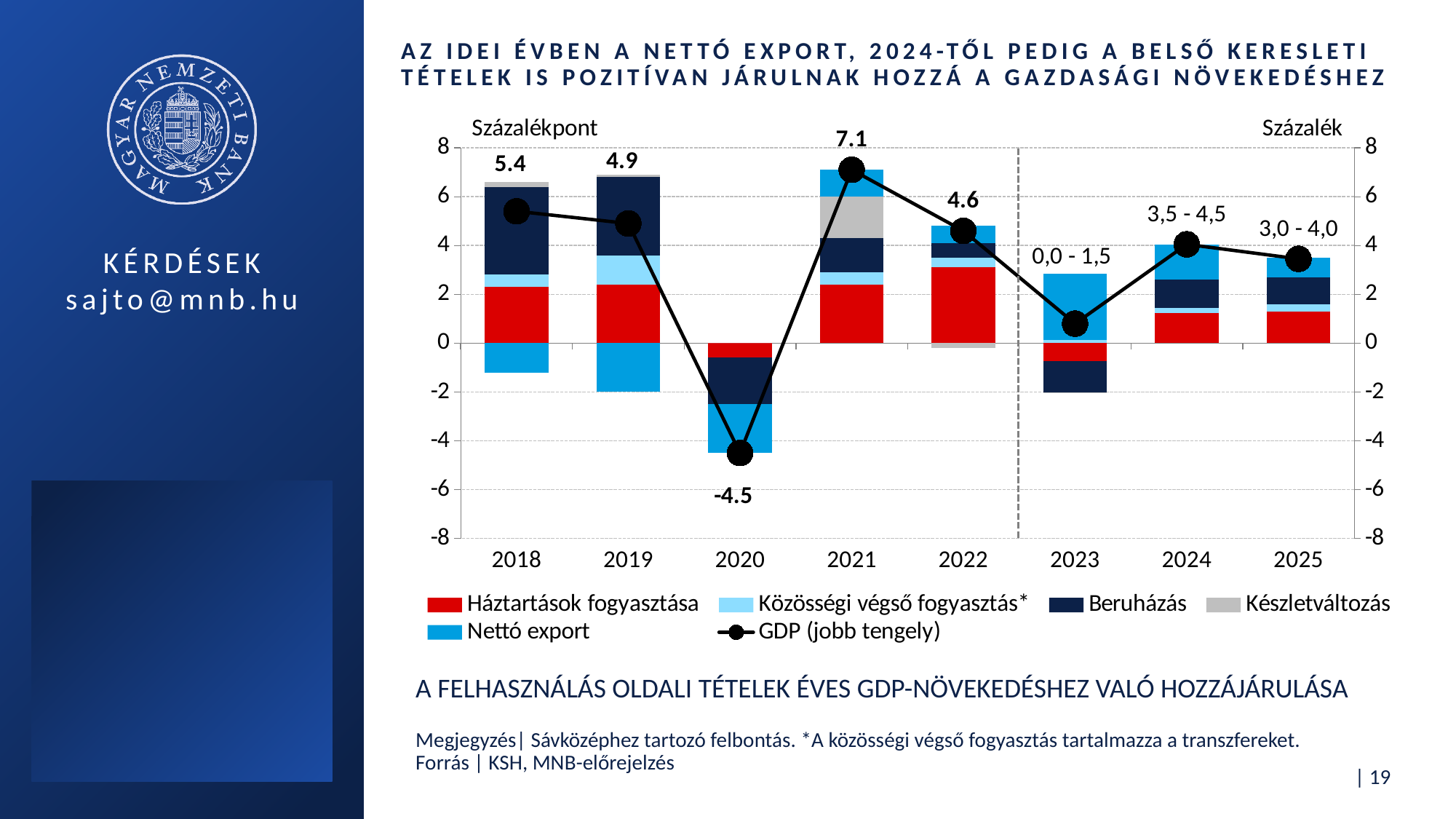
In which year is the GDP line at its highest? 2021 How many series does the legend list? 6 What is the GDP value shown for 2018? 5.4 Which year has the higher GDP value, 2018 or 2019? 2018 What is the difference between the GDP values for 2021 and 2022? 2.5 In which year is the GDP line at its lowest? 2020 What GDP range is shown for 2024? 3,5 - 4,5 What is the GDP value shown for 2021? 7.1 How many years are shown on the x axis? 8 Is the Nettó export value for 2019 greater or less than 0? less What is the label of the left vertical axis? Százalékpont What is the GDP value shown for 2020? -4.5